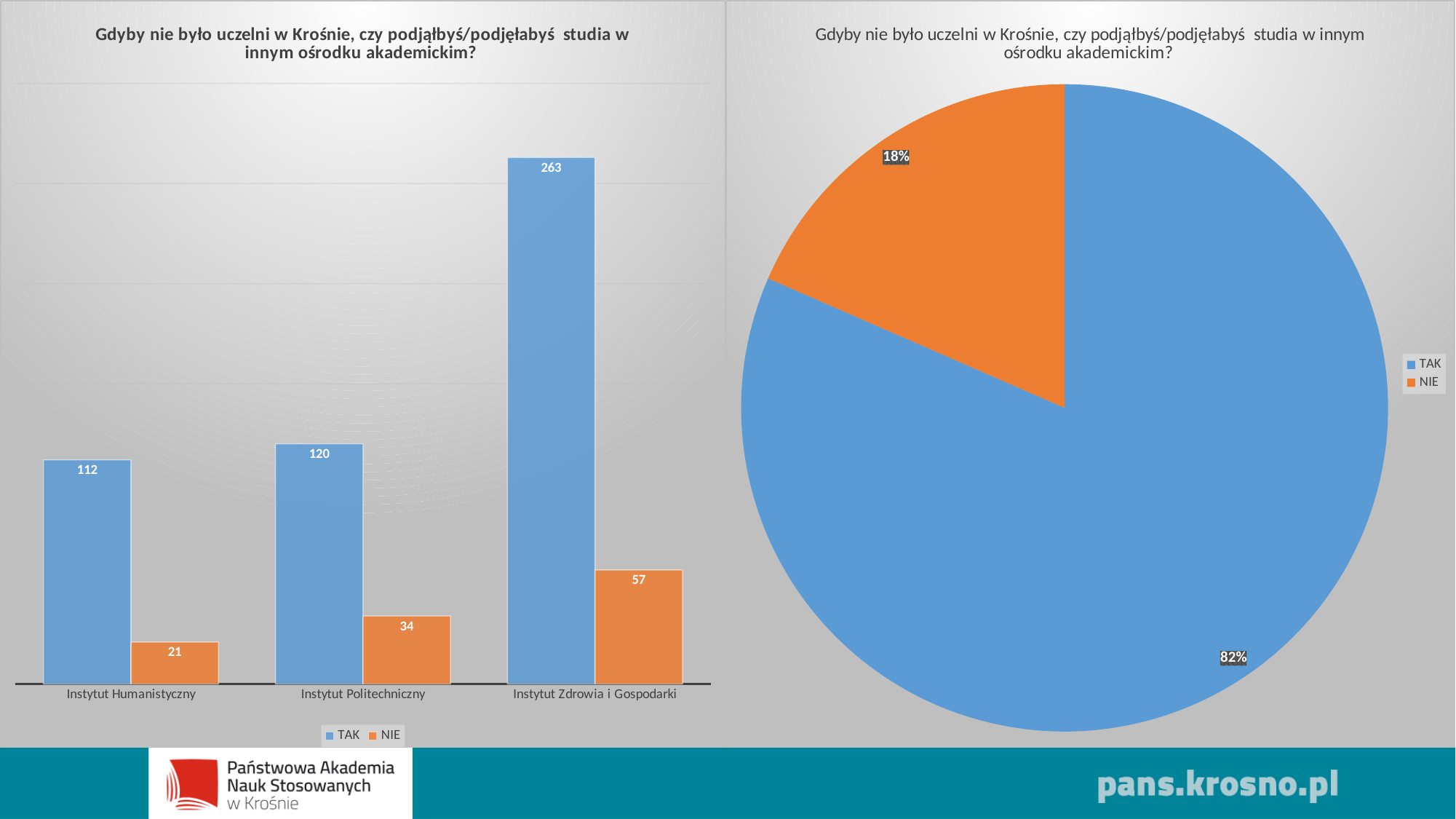
In the bar chart on the left, which institute has the highest TAK value? Instytut Zdrowia i Gospodarki In the pie chart on the right, what share of responses is NIE? 18% How many series does the legend of the bar chart on the left list? 2 In the pie chart on the right, what share of responses is TAK? 82% In the bar chart on the left, what is the TAK value for Instytut Zdrowia i Gospodarki? 263 In the bar chart on the left, what is the NIE value for Instytut Politechniczny? 34 In the bar chart on the left, what is the difference between the TAK and NIE values for Instytut Politechniczny? 86 In the bar chart on the left, is the NIE value for Instytut Zdrowia i Gospodarki larger or smaller than the NIE value for Instytut Humanistyczny? larger How many institutes are shown on the x axis of the bar chart on the left? 3 In the bar chart on the left, what is the TAK value for Instytut Humanistyczny? 112 What kind of chart is the chart on the right? pie chart In the bar chart on the left, which institute has the lowest NIE value? Instytut Humanistyczny